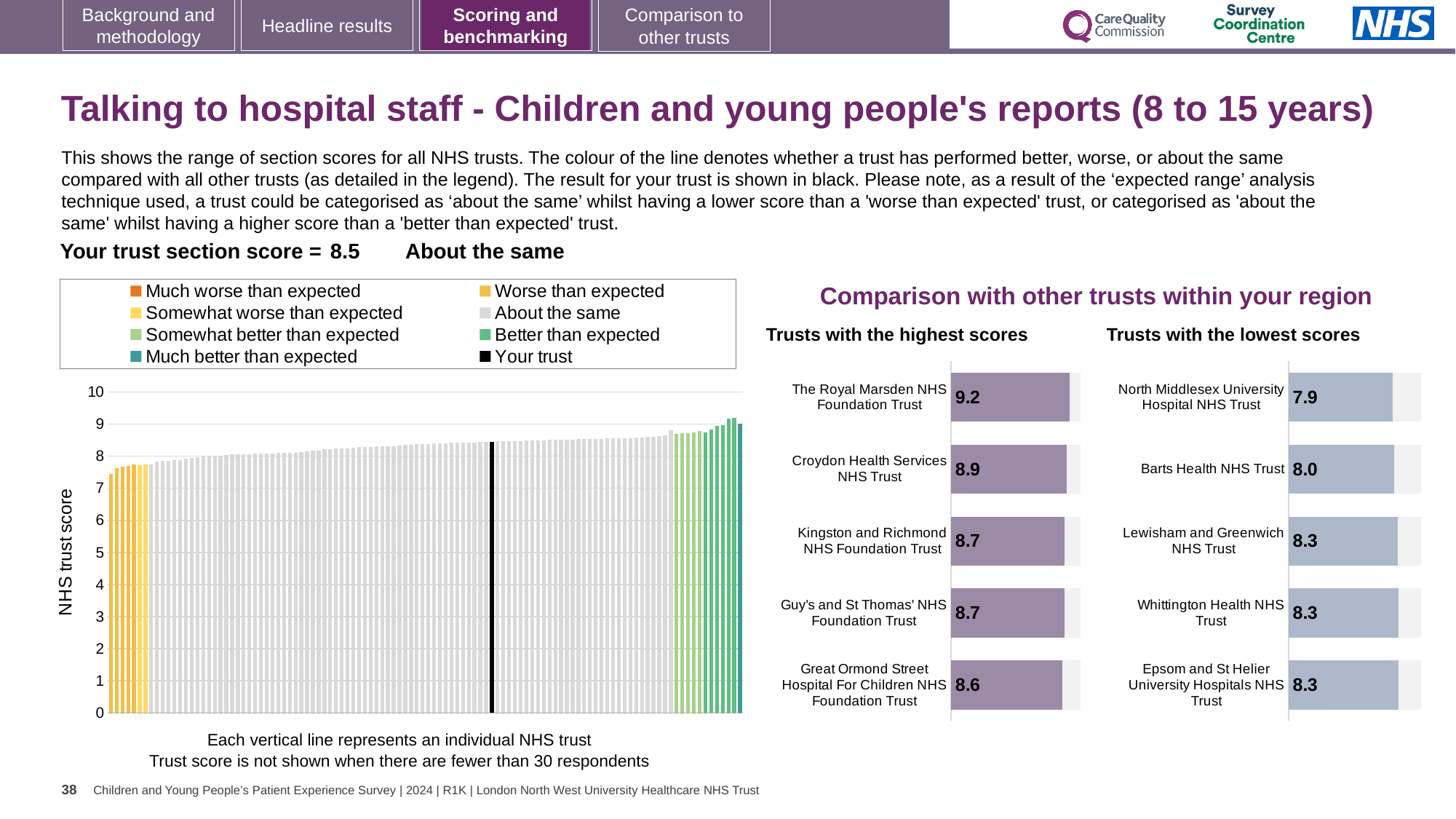
In the 'Trusts with the lowest scores' chart, which is larger: the score for Barts Health NHS Trust or North Middlesex University Hospital NHS Trust? Barts Health NHS Trust In the 'Trusts with the highest scores' chart, what is the difference between The Royal Marsden NHS Foundation Trust and Croydon Health Services NHS Trust? 0.3 In the 'Trusts with the lowest scores' chart, what is the score for North Middlesex University Hospital NHS Trust? 7.9 What kind of chart is the large chart on the left showing NHS trust scores? Bar chart How many trusts are shown in the 'Trusts with the lowest scores' chart? 5 In the 'Trusts with the highest scores' chart, which trust has the lowest score? Great Ormond Street Hospital For Children NHS Foundation Trust In the 'Trusts with the lowest scores' chart, which trust has the lowest score? North Middlesex University Hospital NHS Trust What is the y-axis label of the large chart on the left? NHS trust score In the large chart on the left, is the value for the black 'Your trust' bar greater or less than 8? greater In the 'Trusts with the highest scores' chart, what is the score for Croydon Health Services NHS Trust? 8.9 In the 'Trusts with the highest scores' chart, what is the score for The Royal Marsden NHS Foundation Trust? 9.2 How many entries does the legend of the large chart on the left list? 8